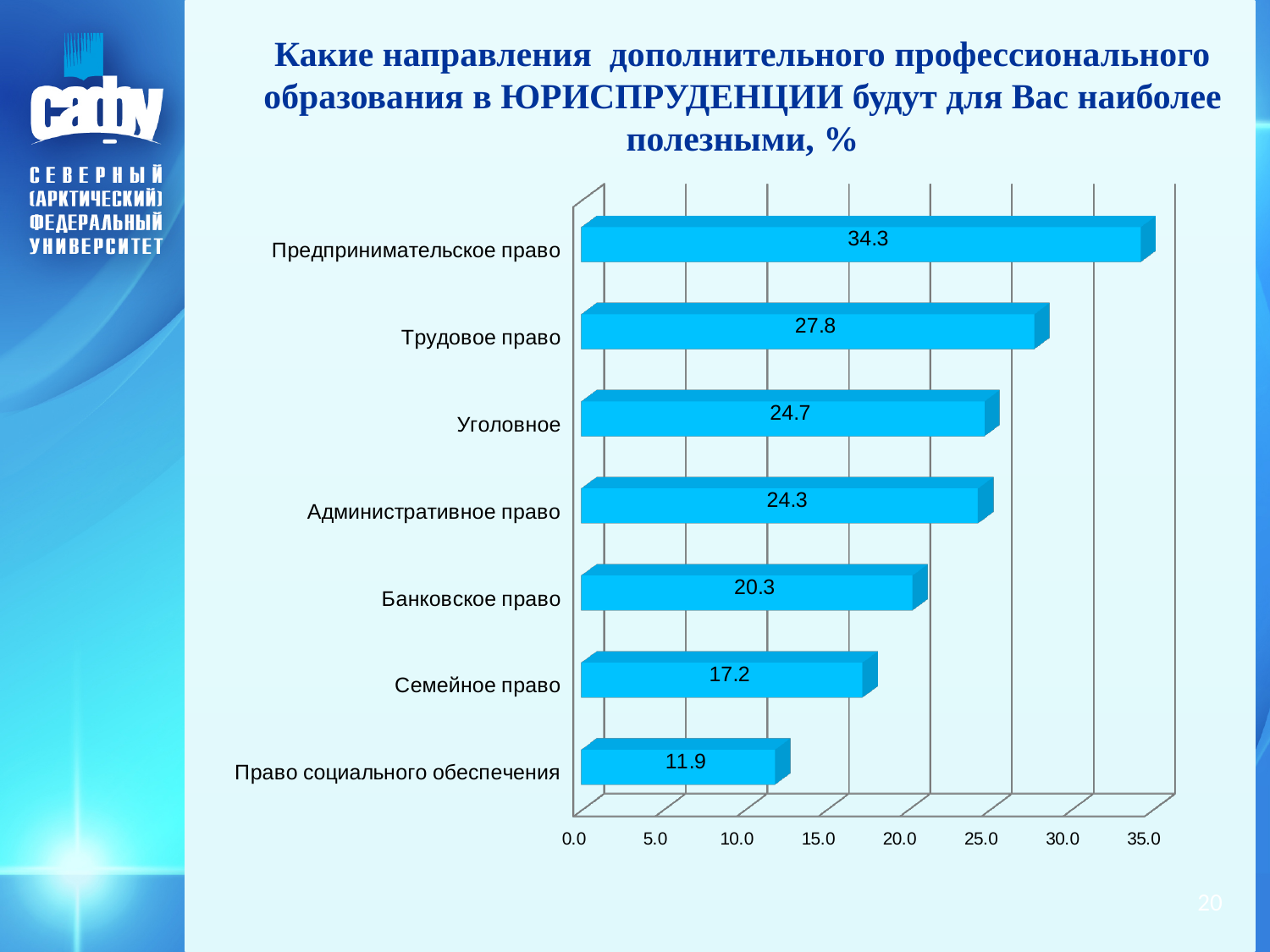
Which category has the lowest value? Право социального обеспечения How many categories are shown in the chart? 7 Which is larger, the value for Уголовное or the value for Банковское право? Уголовное What kind of chart is shown on the slide? bar chart What is the value for Банковское право? 20.3 What is the value for Право социального обеспечения? 11.9 What is the difference between the values for Предпринимательское право and Трудовое право? 6.5 What is the value for Трудовое право? 27.8 Is the value for Семейное право greater or less than 20.0? less What is the value for Предпринимательское право? 34.3 What is the difference between the values for Семейное право and Право социального обеспечения? 5.3 Which category has the highest value? Предпринимательское право